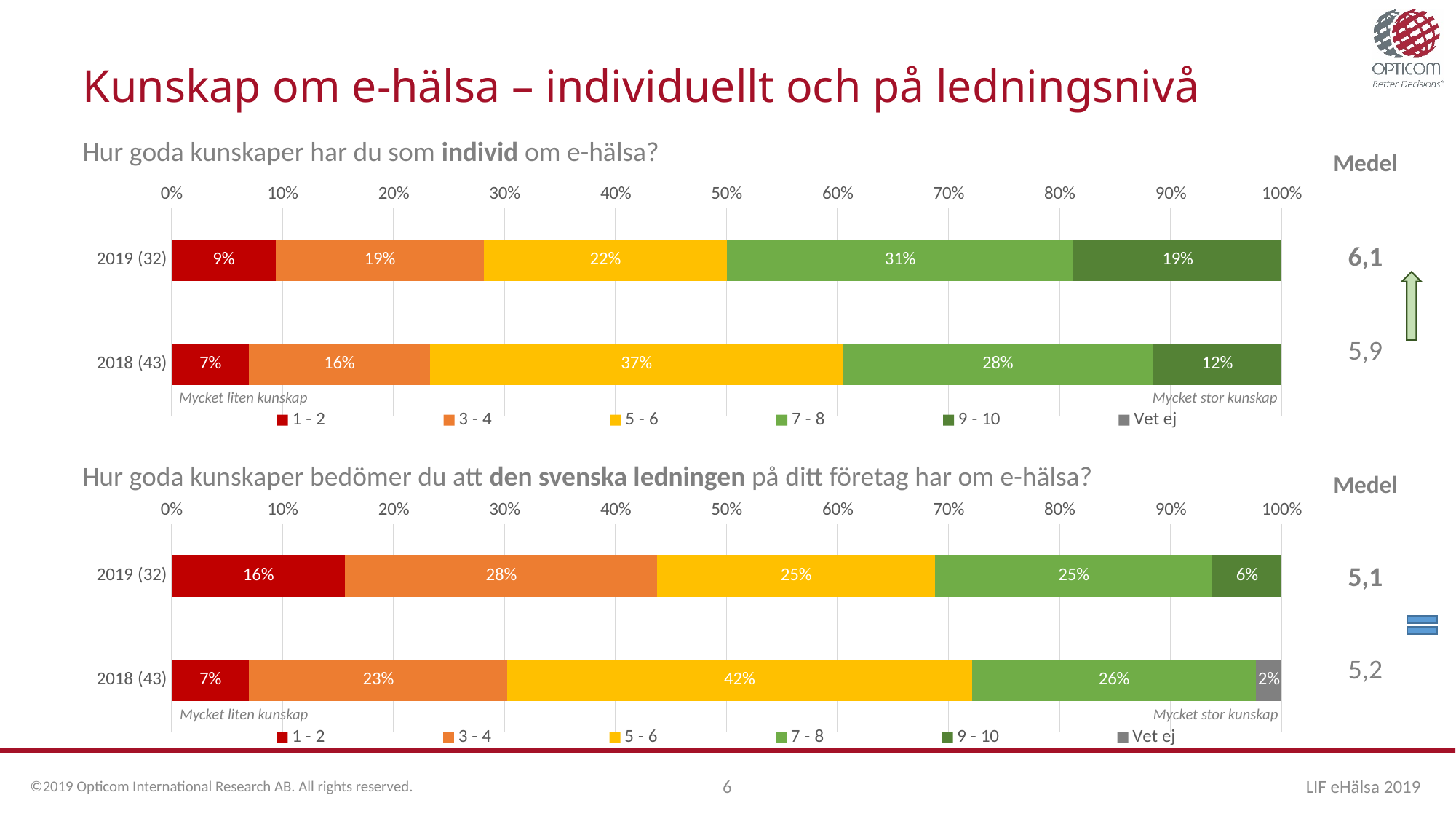
In the top chart (individual knowledge of e-health), which answer category has the largest share for 2019 (32)? 7 - 8 What is the Medel (mean) value shown for 2018 (43) in the bottom chart (Swedish management's knowledge of e-health)? 5,2 In the bottom chart (Swedish management's knowledge of e-health), what percentage of 2018 (43) respondents answered Vet ej? 2% In the top chart (individual knowledge of e-health), what is the difference between the 9 - 10 share for 2019 (32) and for 2018 (43)? 7 percentage points In the top chart (individual knowledge of e-health), what percentage of 2018 (43) respondents answered 5 - 6? 37% In the bottom chart (Swedish management's knowledge of e-health), which answer category has the largest share for 2018 (43)? 5 - 6 How many series does the legend of the top chart list? 6 In the bottom chart (Swedish management's knowledge of e-health), what percentage of 2019 (32) respondents answered 1 - 2? 16% In the top chart (individual knowledge of e-health), what percentage of 2019 (32) respondents answered 7 - 8? 31% What kind of chart is used on this slide? Stacked bar chart What is the Medel (mean) value shown for 2019 (32) in the top chart (individual knowledge of e-health)? 6,1 In the bottom chart (Swedish management's knowledge of e-health), which is larger: the 3 - 4 share for 2019 (32) or for 2018 (43)? 2019 (32)